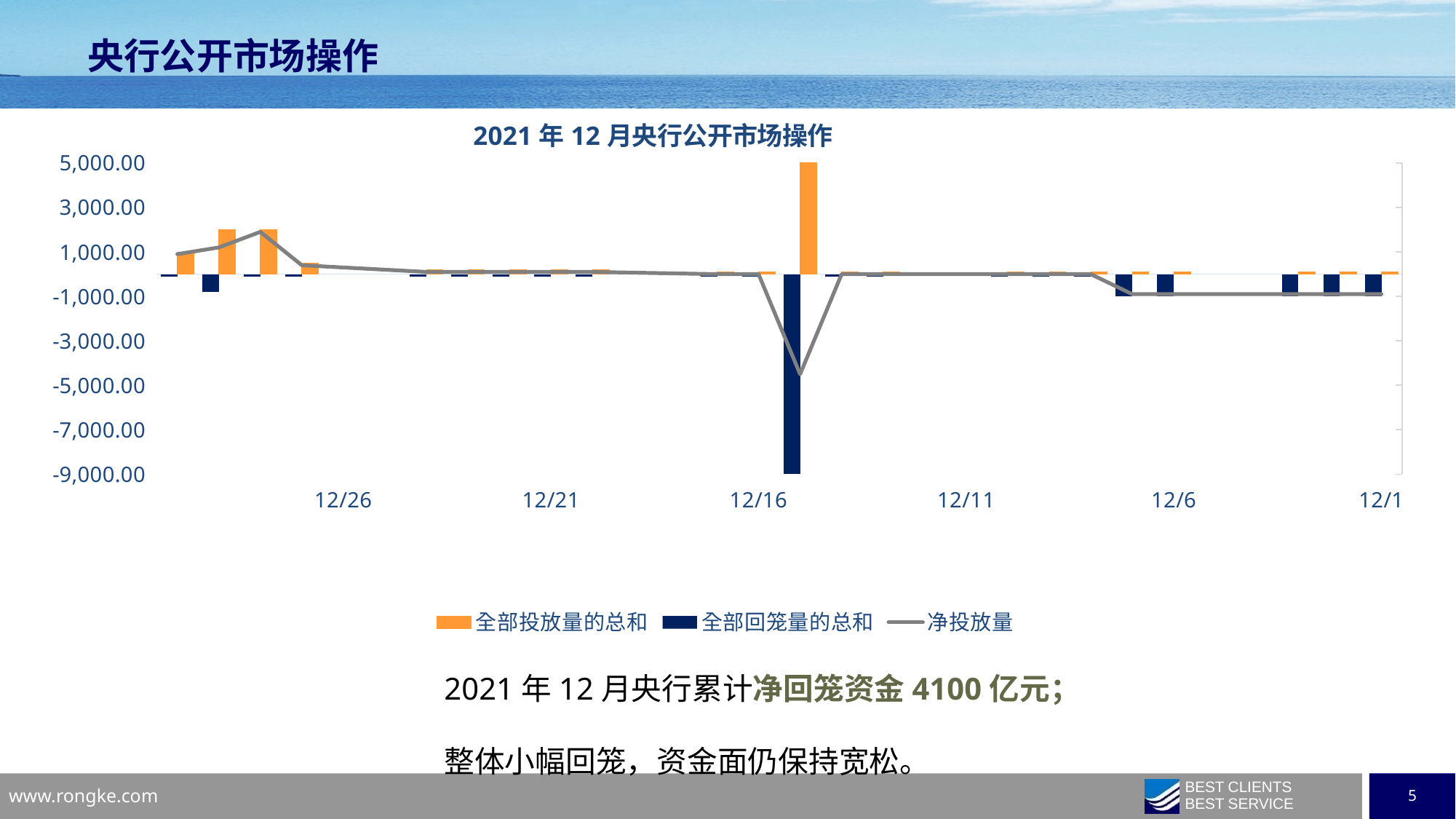
What kind of chart is shown on the slide? A combined bar and line chart Is the lowest 全部回笼量的总和 bar greater or less than -7,000.00? less Is the tallest 全部投放量的总和 bar greater or less than 3,000.00? greater How many series does the chart legend list? 3 What is the title of the chart? 2021 年 12 月央行公开市场操作 Is the highest point of the 净投放量 line greater or less than 1,000.00? greater What is the lowest value shown on the y axis? -9,000.00 Which date label appears at the far right end of the x axis? 12/1 Which is larger in magnitude: the tallest 全部投放量的总和 bar or the deepest 全部回笼量的总和 bar? 全部回笼量的总和 Which series is drawn as a grey line? 净投放量 How many date labels are shown on the x axis? 6